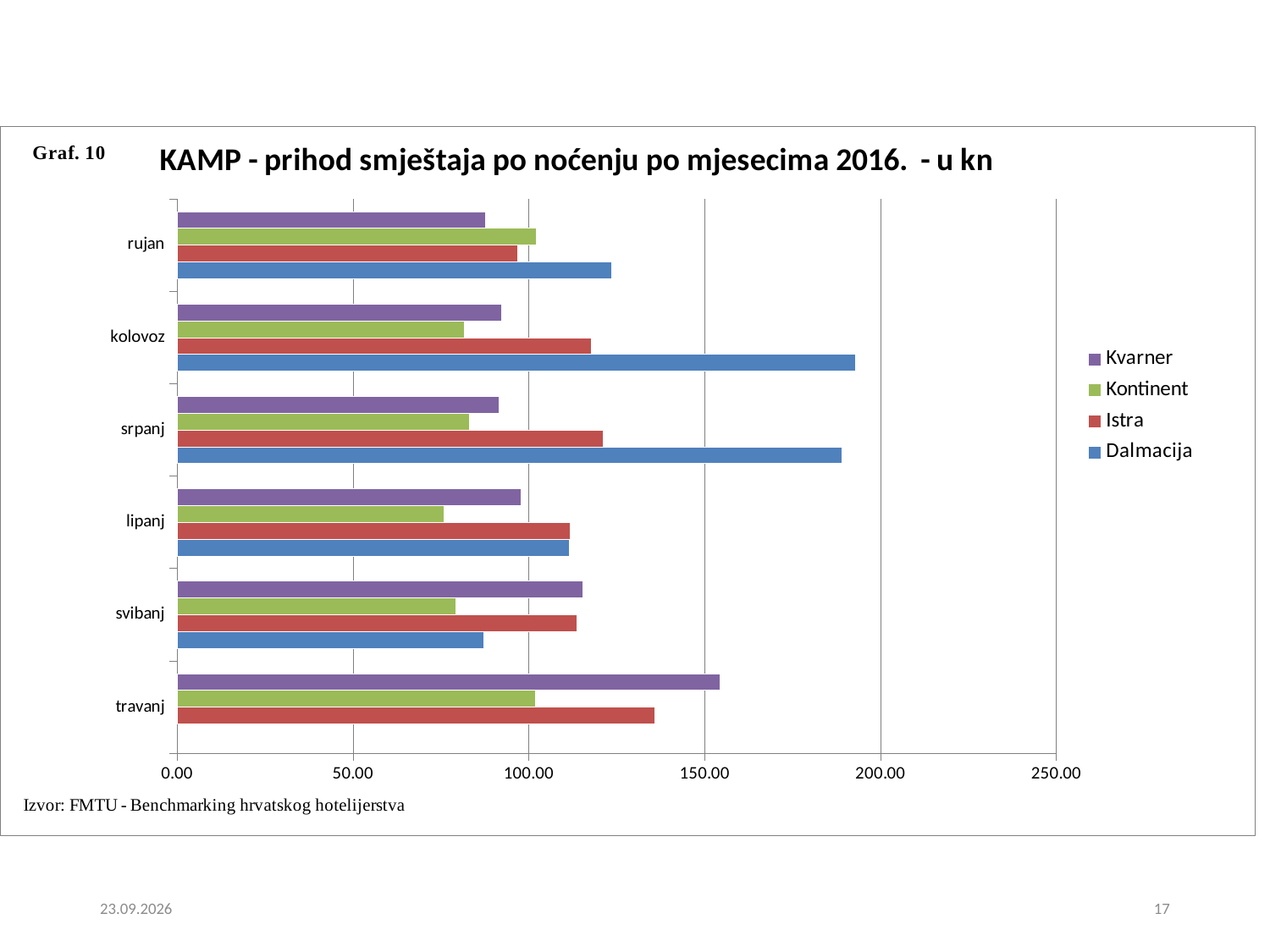
Which is larger in svibanj, the value for Kontinent or the value for Istra? Istra Which is larger in srpanj, the value for Dalmacija or the value for Kvarner? Dalmacija Which series has no bar shown for travanj? Dalmacija Which region has the highest value in kolovoz? Dalmacija How many months (categories) are shown on the vertical axis? 6 Is the value for Kontinent in lipanj greater or less than 100.00? less How many series does the legend list? 4 In which month does Istra reach its highest value? travanj What kind of chart is shown on the slide? bar chart Is the value for Dalmacija in svibanj greater or less than 100.00? less In which month does Kvarner reach its highest value? travanj Is the value for Dalmacija in kolovoz greater or less than 150.00? greater